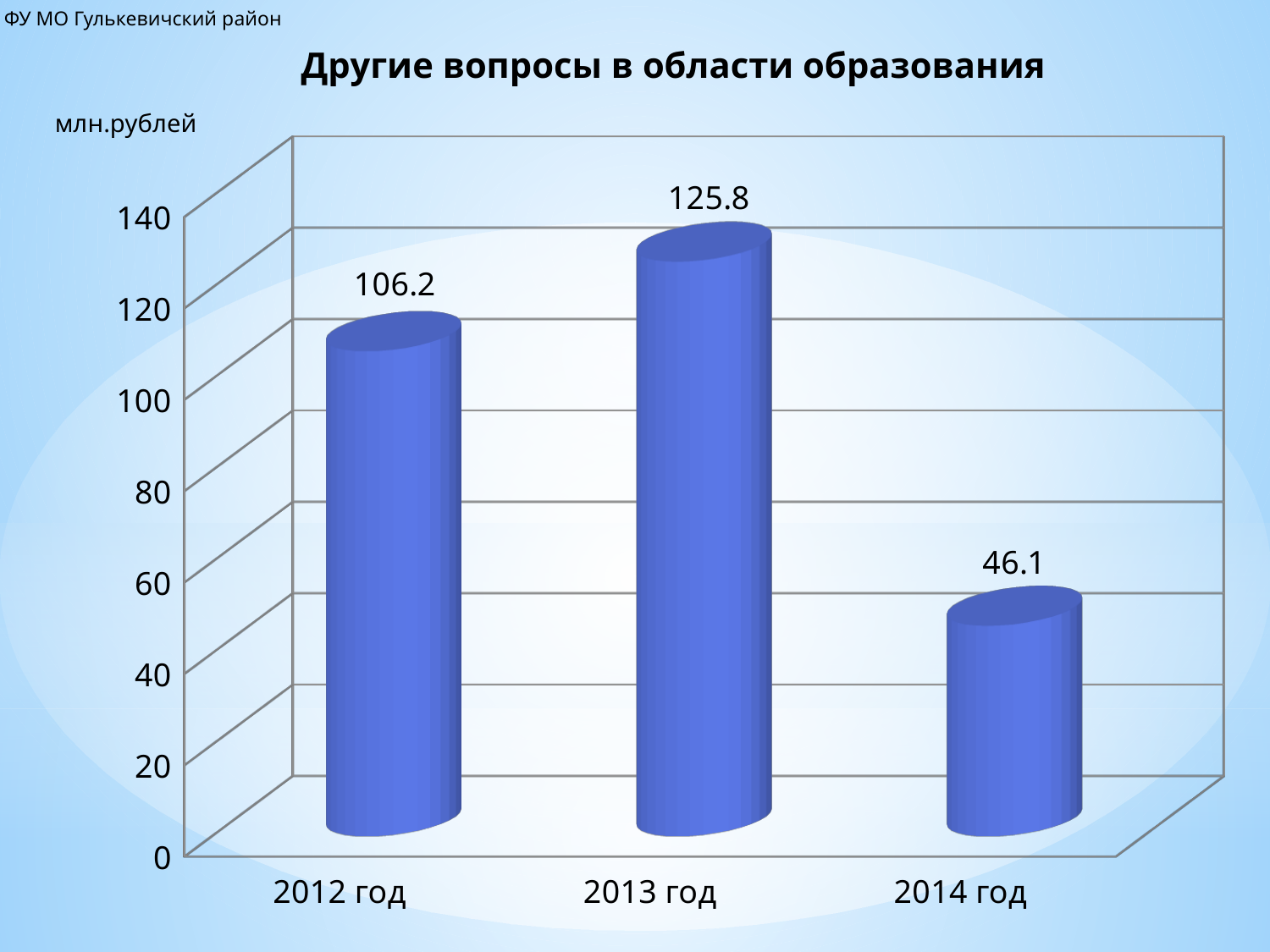
Which year has the highest value? 2013 год Which is larger, the value for 2012 год or the value for 2014 год? 2012 год What is the title of the chart? Другие вопросы в области образования What is the value for 2014 год? 46.1 What is the difference between the values for 2012 год and 2014 год? 60.1 What is the value for 2013 год? 125.8 What is the difference between the values for 2013 год and 2012 год? 19.6 How many years are shown on the chart? 3 What kind of chart is shown on the slide? bar chart Which year has the lowest value? 2014 год What is the value for 2012 год? 106.2 Is the value for 2014 год greater or less than 60? less